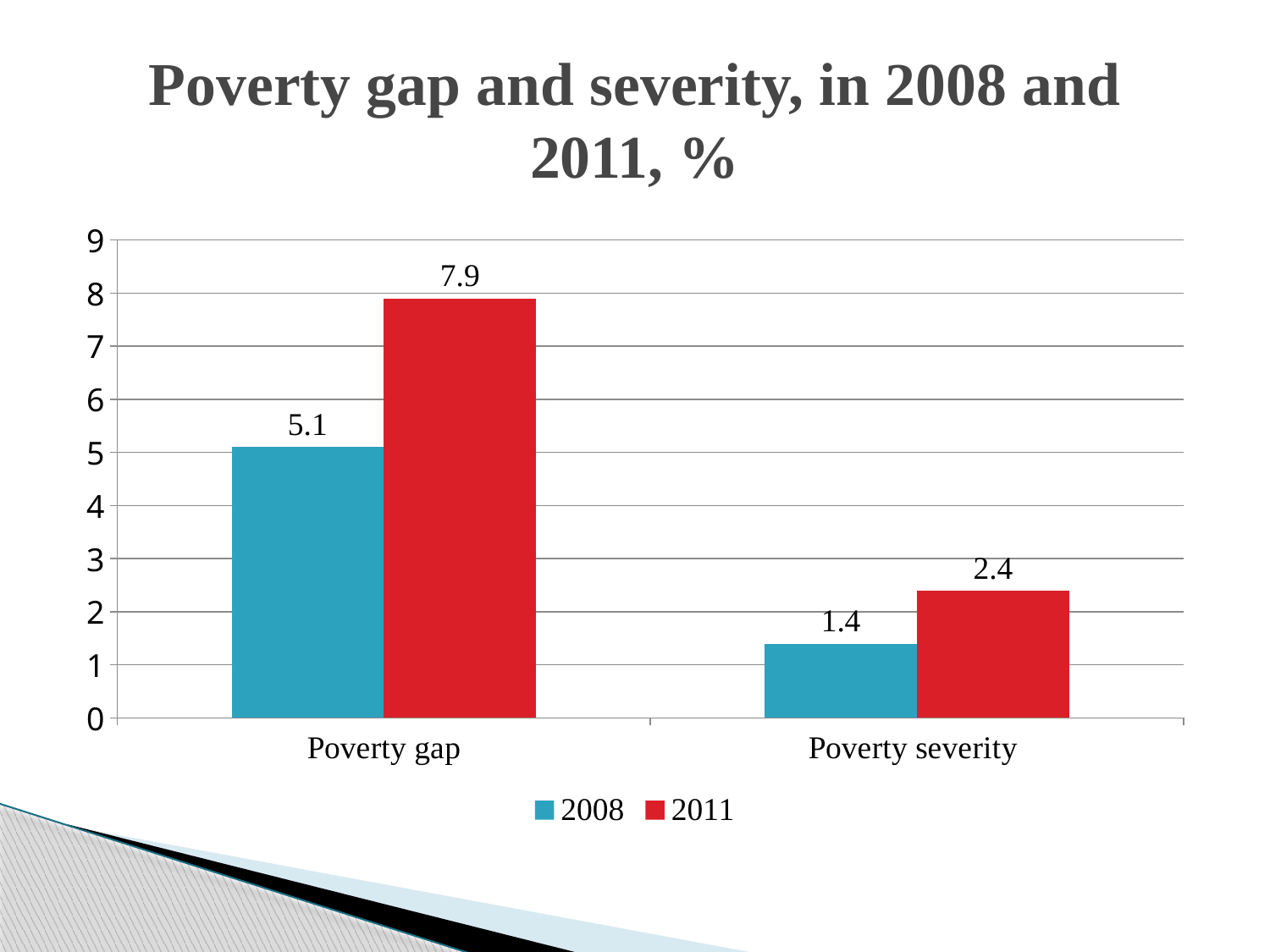
What is the poverty gap value for 2011? 7.9 What is the difference between the 2011 and 2008 values for poverty severity? 1.0 What is the poverty severity value for 2011? 2.4 What type of chart is shown on the slide? Bar chart What is the poverty severity value for 2008? 1.4 How many categories are shown on the x axis? 2 How many series does the legend list? 2 What is the poverty gap value for 2008? 5.1 By how much did the poverty gap increase from 2008 to 2011? 2.8 Which bar has the highest value on the chart? Poverty gap, 2011 Which bar has the lowest value on the chart? Poverty severity, 2008 Which is larger, the poverty gap in 2008 or the poverty severity in 2011? Poverty gap in 2008